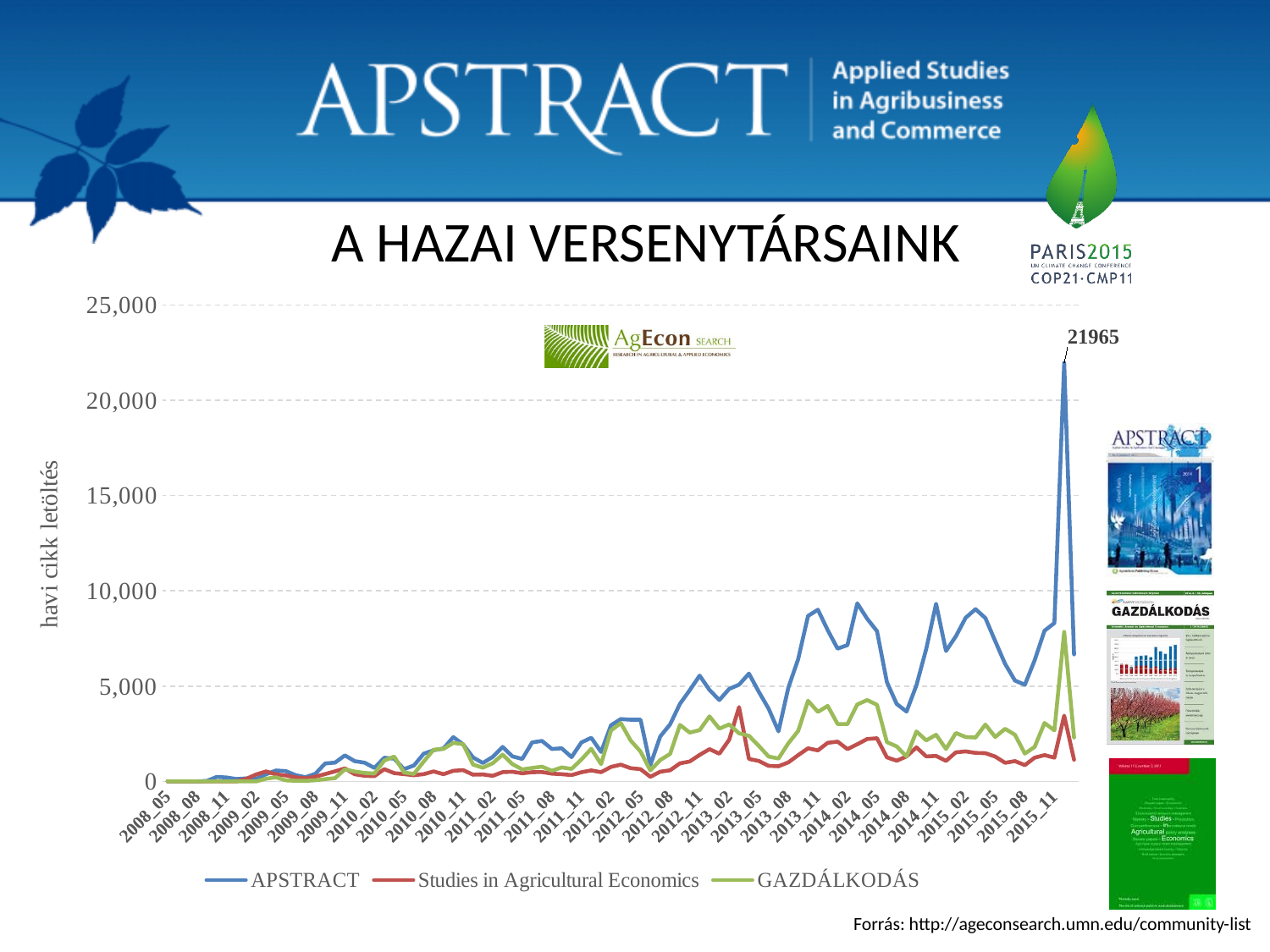
Overall, do the APSTRACT values rise or fall from 2008_05 to 2015_11? rise What type of chart is shown on the slide? line chart What is the label on the vertical axis? havi cikk letöltés Is the highest value of the GAZDÁLKODÁS series greater or less than 10,000? less Is the peak value of the APSTRACT series greater or less than 20,000? greater What are the three series named in the legend? APSTRACT, Studies in Agricultural Economics, GAZDÁLKODÁS Which series has the lowest peak value on the chart? Studies in Agricultural Economics What is the peak value printed on the chart for the APSTRACT series? 21965 Which series reaches the highest value on the chart? APSTRACT How many series does the legend list? 3 Is the highest value of the Studies in Agricultural Economics series greater or less than 5,000? less At the last point on the x axis (2015_11), which series has the larger value, APSTRACT or GAZDÁLKODÁS? APSTRACT